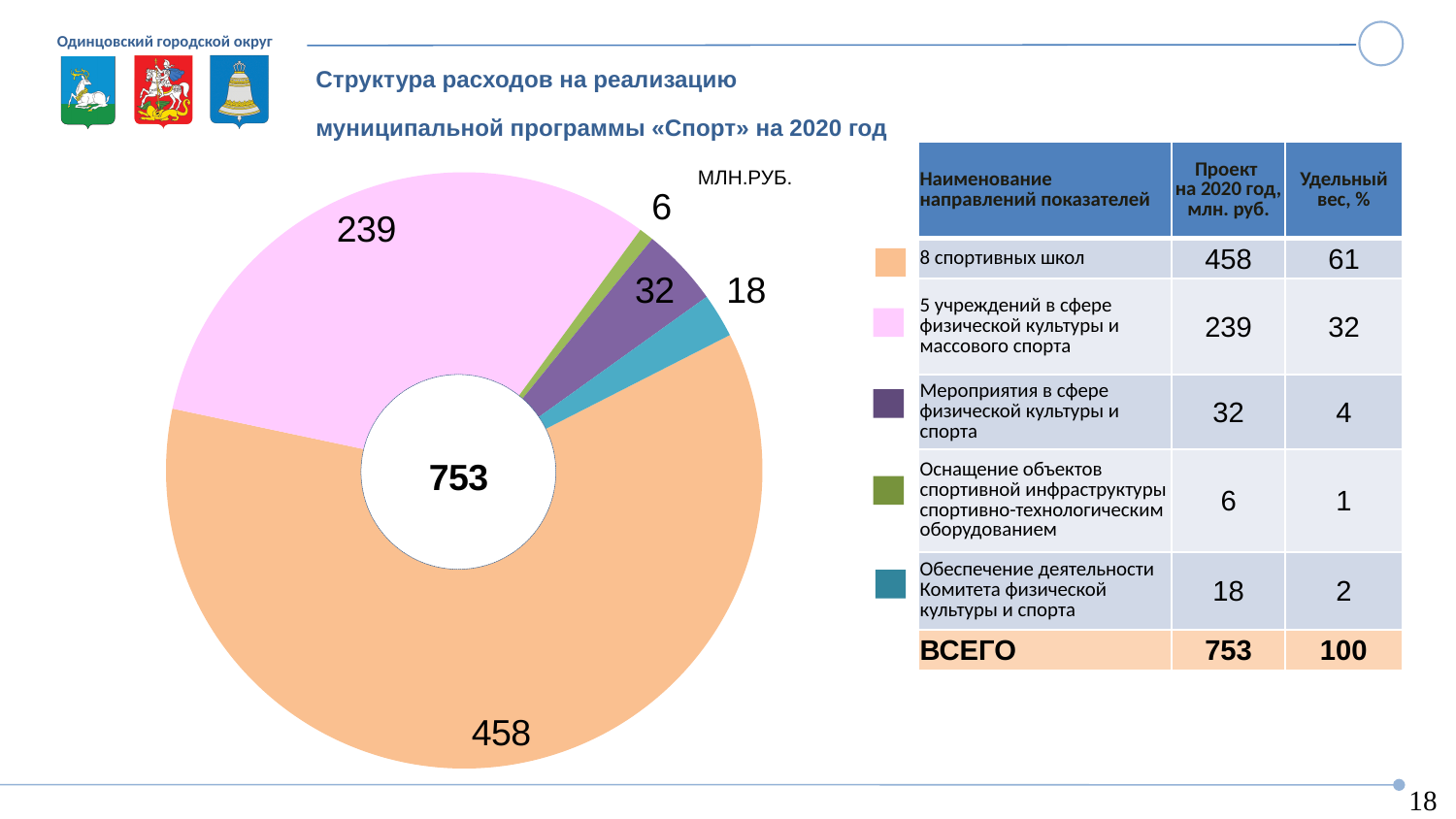
What share of the total do the 8 sports schools account for, according to the table? 61% What is the difference between the 458 segment and the 239 segment? 219 How many segments does the doughnut chart have? 5 Which category has the smallest segment in the chart? Оснащение объектов спортивной инфраструктуры спортивно-технологическим оборудованием What kind of chart is shown on the slide? Doughnut (pie) chart Which category has the largest segment in the chart? 8 спортивных школ What is the value for the 5 institutions in physical culture and mass sports (5 учреждений в сфере физической культуры и массового спорта)? 239 Which is larger: the segment for events in physical culture and sports (32) or the segment for the Committee's activities (18)? Мероприятия в сфере физической культуры и спорта (32) What is the value for ensuring the activities of the Committee of Physical Culture and Sports (Обеспечение деятельности Комитета физической культуры и спорта)? 18 What is the total shown in the centre of the doughnut chart? 753 What is the value for events in physical culture and sports (Мероприятия в сфере физической культуры и спорта)? 32 What is the value for the 8 sports schools (8 спортивных школ) segment? 458